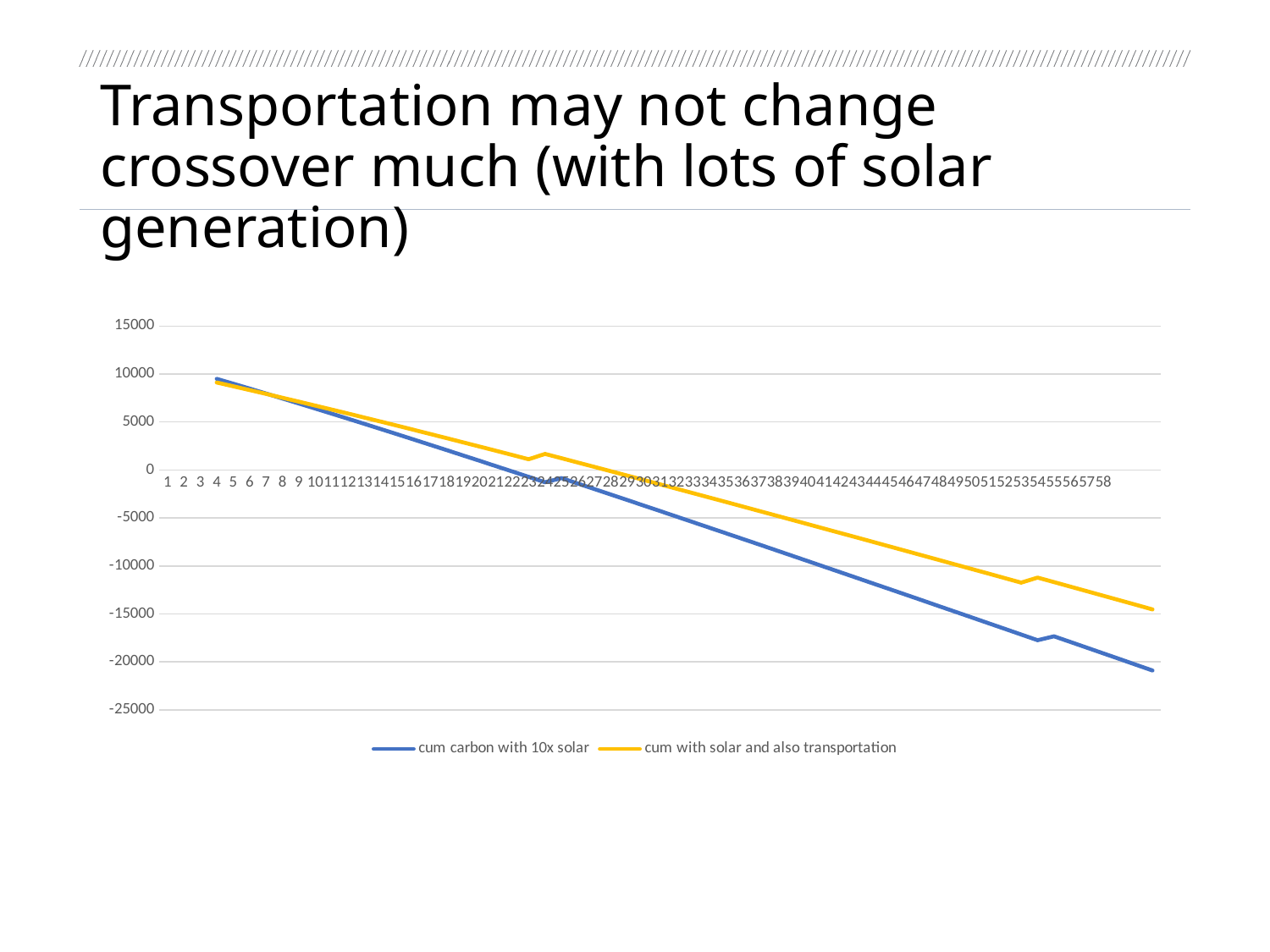
Is the value for 'cum with solar and also transportation' at x = 58 greater or less than -10000? less Do the values of 'cum with solar and also transportation' rise or fall along the x axis? fall How many series does the legend list? 2 What are the two series named in the legend? cum carbon with 10x solar; cum with solar and also transportation At x = 58, which series has the higher value, 'cum carbon with 10x solar' or 'cum with solar and also transportation'? cum with solar and also transportation What is the highest label shown on the x axis? 58 What kind of chart is shown on the slide? line chart Do the values of 'cum carbon with 10x solar' rise or fall along the x axis? fall At x = 40, which series has the lower value, 'cum carbon with 10x solar' or 'cum with solar and also transportation'? cum carbon with 10x solar Is the value for 'cum carbon with 10x solar' at x = 58 greater or less than -15000? less Which colour is the line for 'cum with solar and also transportation'? yellow Is the value for 'cum carbon with 10x solar' at x = 20 greater or less than 0? greater